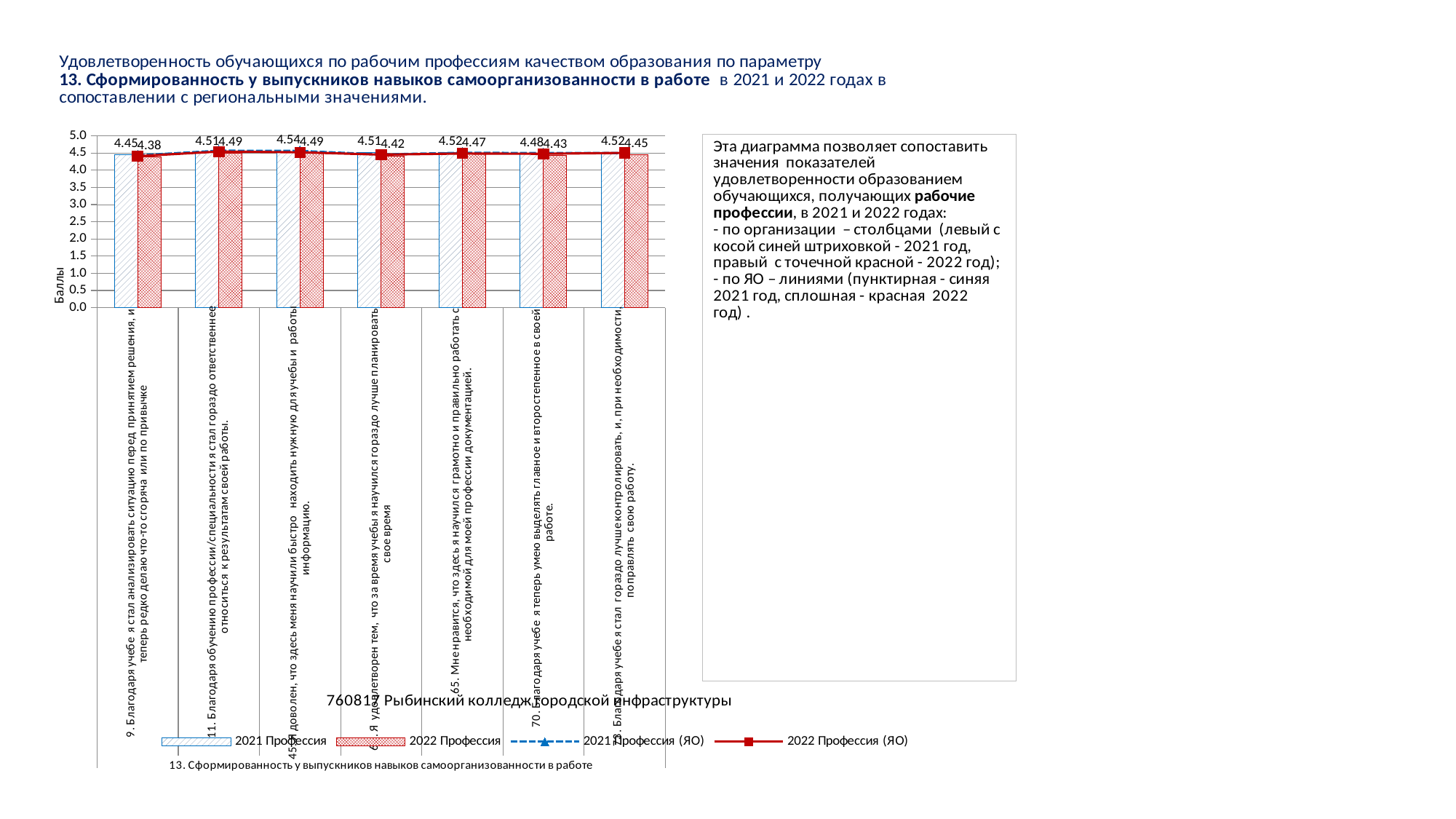
How many series does the legend list? 4 What type of chart is used for the Профессия values by organisation? Bar chart What is the difference between the 2021 and 2022 Профессия values for item 11 (стал гораздо ответственнее относиться к результатам своей работы)? 0.02 Which item has the lowest 2022 Профессия value? 9 (Благодаря учебе я стал анализировать ситуацию перед принятием решения) What is the 2022 Профессия value for item 65 (научился грамотно и правильно работать с документацией)? 4.47 What is the label of the vertical axis? Баллы How many items (categories) are plotted on the x axis? 7 For item 70, which is larger: the 2021 Профессия value or the 2022 Профессия value? 2021 Профессия What is the 2021 Профессия value for item 9 (Благодаря учебе я стал анализировать ситуацию перед принятием решения)? 4.45 What is the 2021 Профессия value for item 70 (умею выделять главное и второстепенное в своей работе)? 4.48 Which item has the highest 2021 Профессия value? 45 (научили быстро находить нужную для учебы и работы информацию) What is the 2022 Профессия value for item 9 (Благодаря учебе я стал анализировать ситуацию перед принятием решения)? 4.38